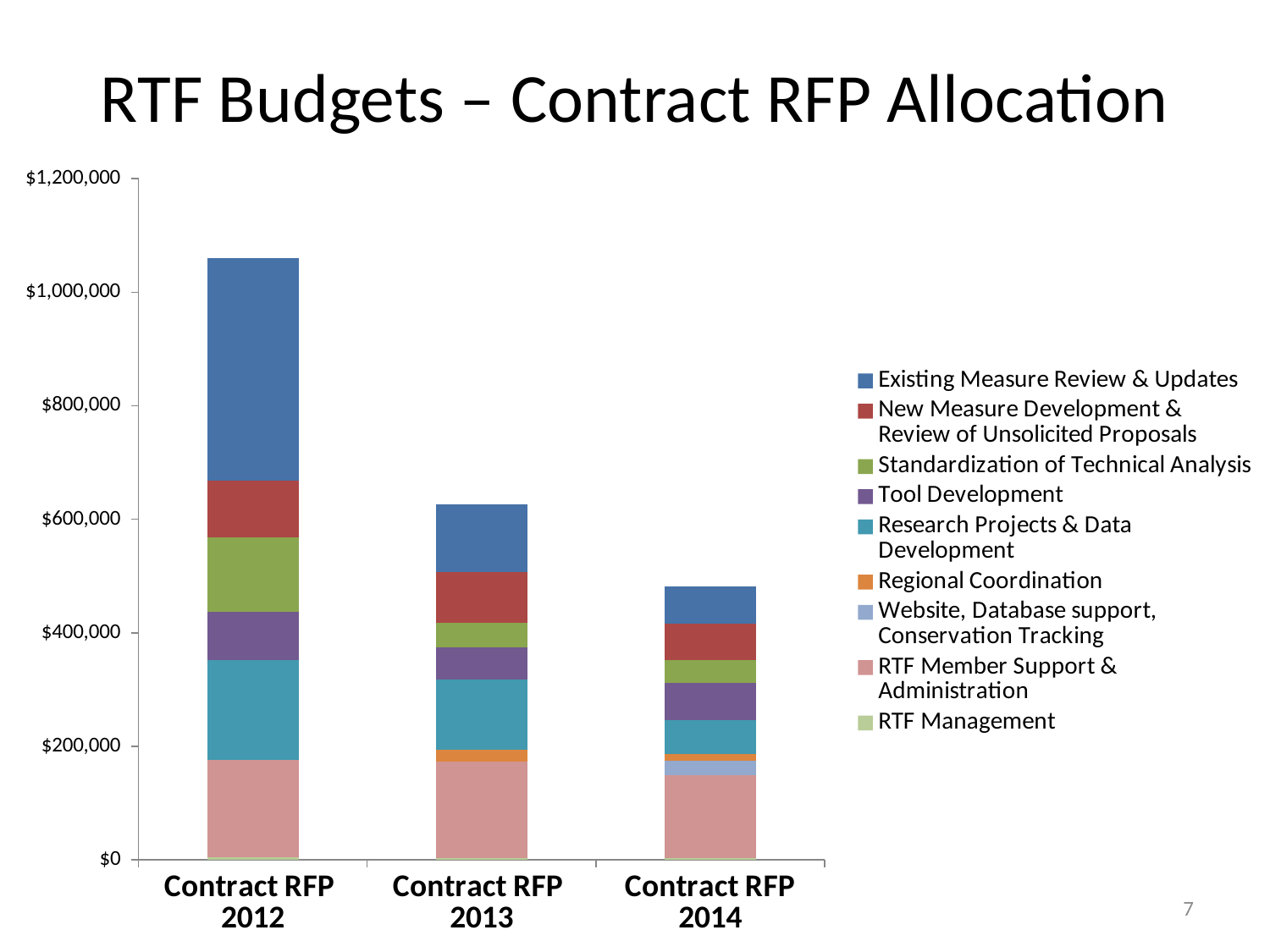
How many series does the legend list? 9 Is the total for Contract RFP 2014 greater or less than $600,000? less Is the total for Contract RFP 2013 greater or less than $600,000? greater Which category has the shortest stacked bar? Contract RFP 2014 Which category has the tallest stacked bar? Contract RFP 2012 What is the title of the chart on the slide? RTF Budgets – Contract RFP Allocation Is the total for Contract RFP 2012 greater or less than $1,000,000? greater Which series is listed first in the legend? Existing Measure Review & Updates Which is larger, the total for Contract RFP 2012 or the total for Contract RFP 2013? Contract RFP 2012 What kind of chart is shown on the slide? Stacked bar chart Do the total bar heights rise or fall from Contract RFP 2012 to Contract RFP 2014? Fall How many categories (bars) are shown on the x axis? 3